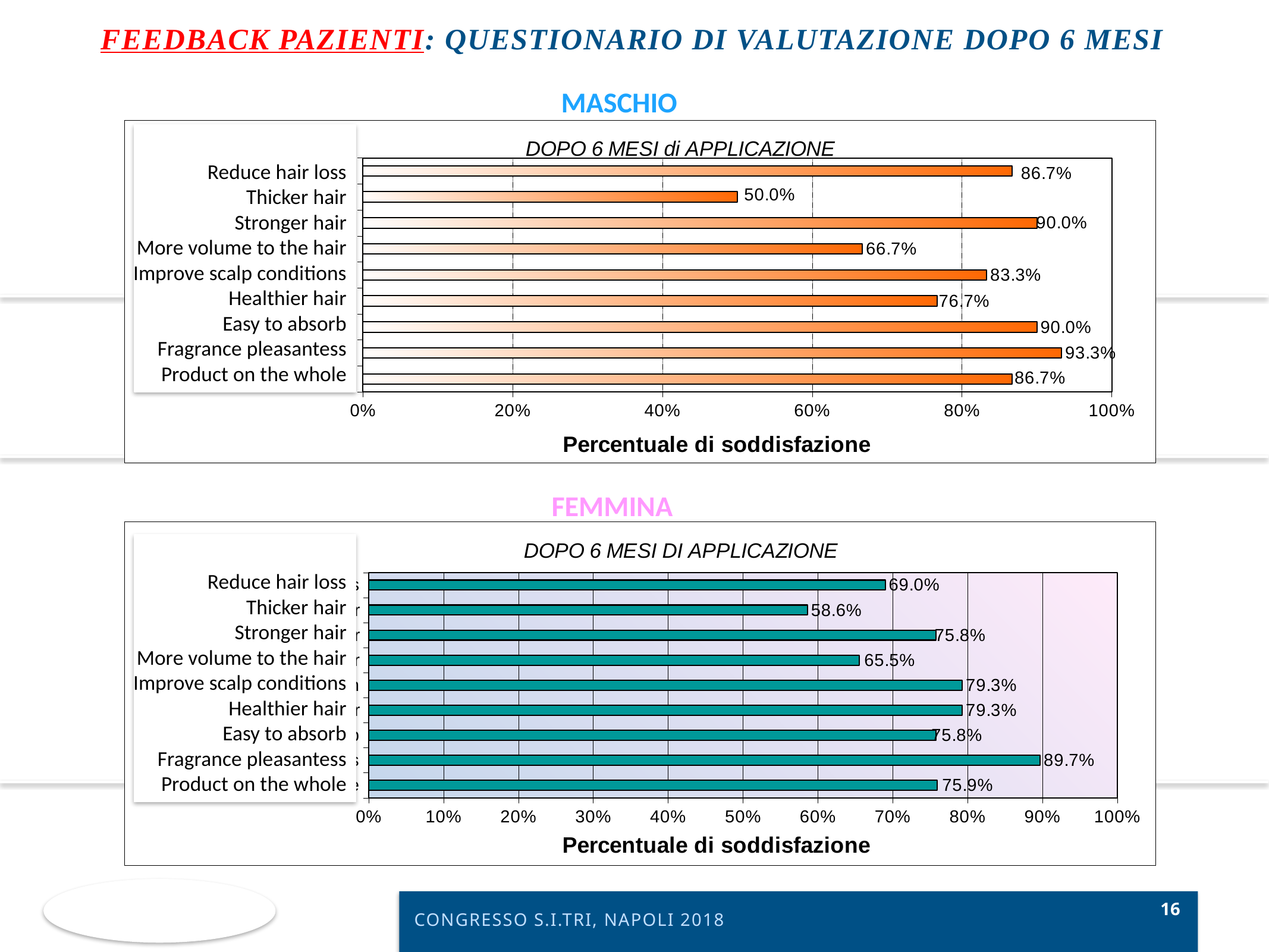
In the FEMMINA chart, what is the value for Product on the whole? 75.9% In the FEMMINA chart, which category has the highest value? Fragrance pleasantess In the MASCHIO chart, which category has the lowest value? Thicker hair In the MASCHIO chart, what is the value for Improve scalp conditions? 83.3% In the MASCHIO chart, which category has the highest value? Fragrance pleasantess In the FEMMINA chart, which is larger, Healthier hair or More volume to the hair? Healthier hair In the MASCHIO chart, what is the value for Thicker hair? 50.0% What kind of chart is the FEMMINA chart? Bar chart In the FEMMINA chart, what is the value for Reduce hair loss? 69.0% In the FEMMINA chart, which category has the lowest value? Thicker hair How many categories does the MASCHIO chart show? 9 In the MASCHIO chart, what is the difference between Stronger hair and Thicker hair? 40.0 percentage points